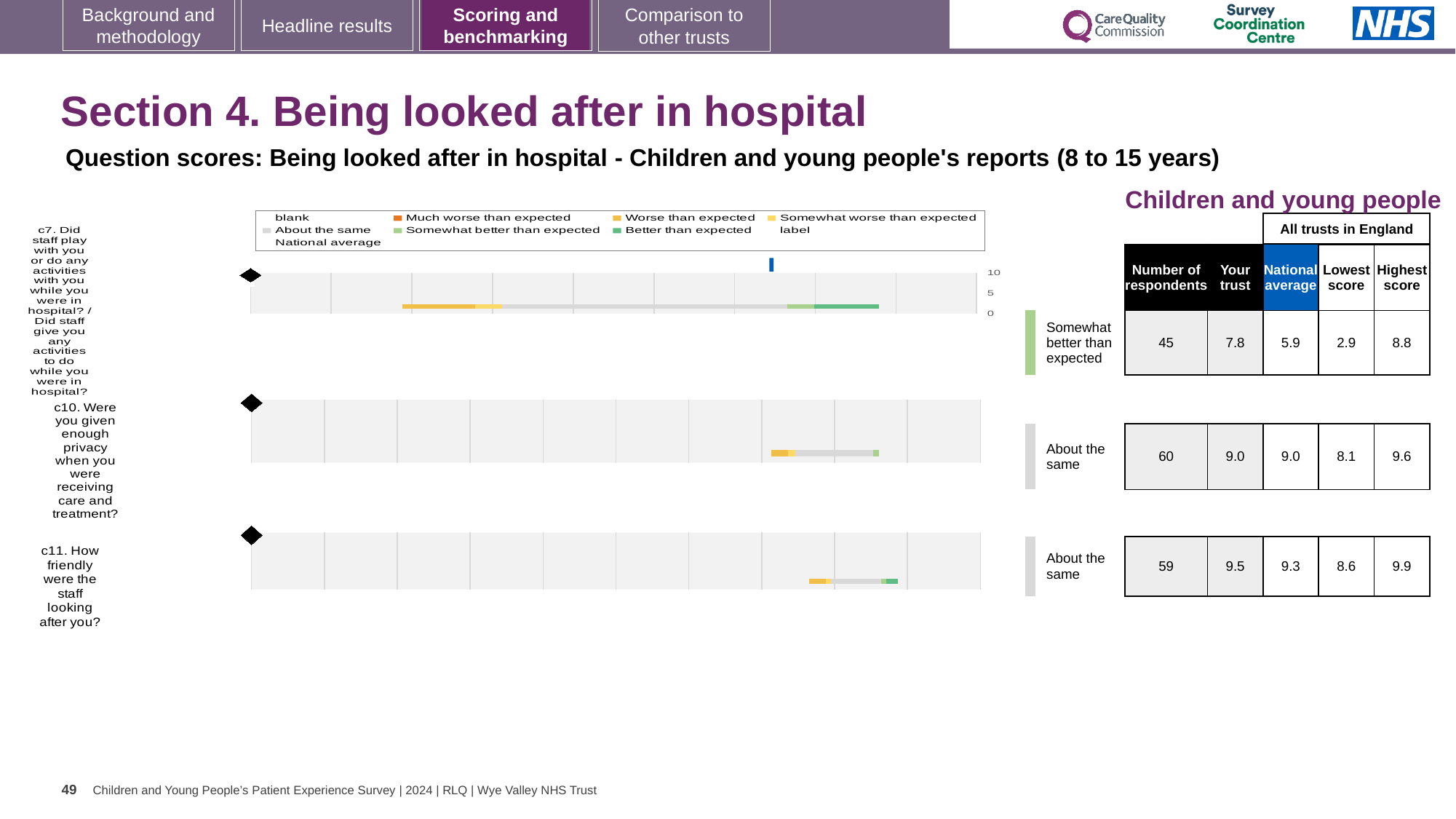
What kind of chart is used to show the question scores on this slide? bar chart What is the 'Your trust' score for question c7 (Did staff play with you or do any activities with you while you were in hospital?)? 7.8 What is the national average score for question c7? 5.9 What is the difference between the trust's score and the national average for question c11? 0.2 What is the lowest score among all trusts in England for question c7? 2.9 For question c7, which is higher: the trust's score or the national average? the trust's score How many questions are plotted in the chart? 3 What is the highest score among all trusts in England for question c11 (How friendly were the staff looking after you?)? 9.9 Which question has the highest 'Your trust' score? c11. How friendly were the staff looking after you? How many respondents answered question c10 (Were you given enough privacy when you were receiving care and treatment?)? 60 By how much does the trust's score for question c7 exceed the national average? 1.9 Which benchmark category is shown for question c7? Somewhat better than expected